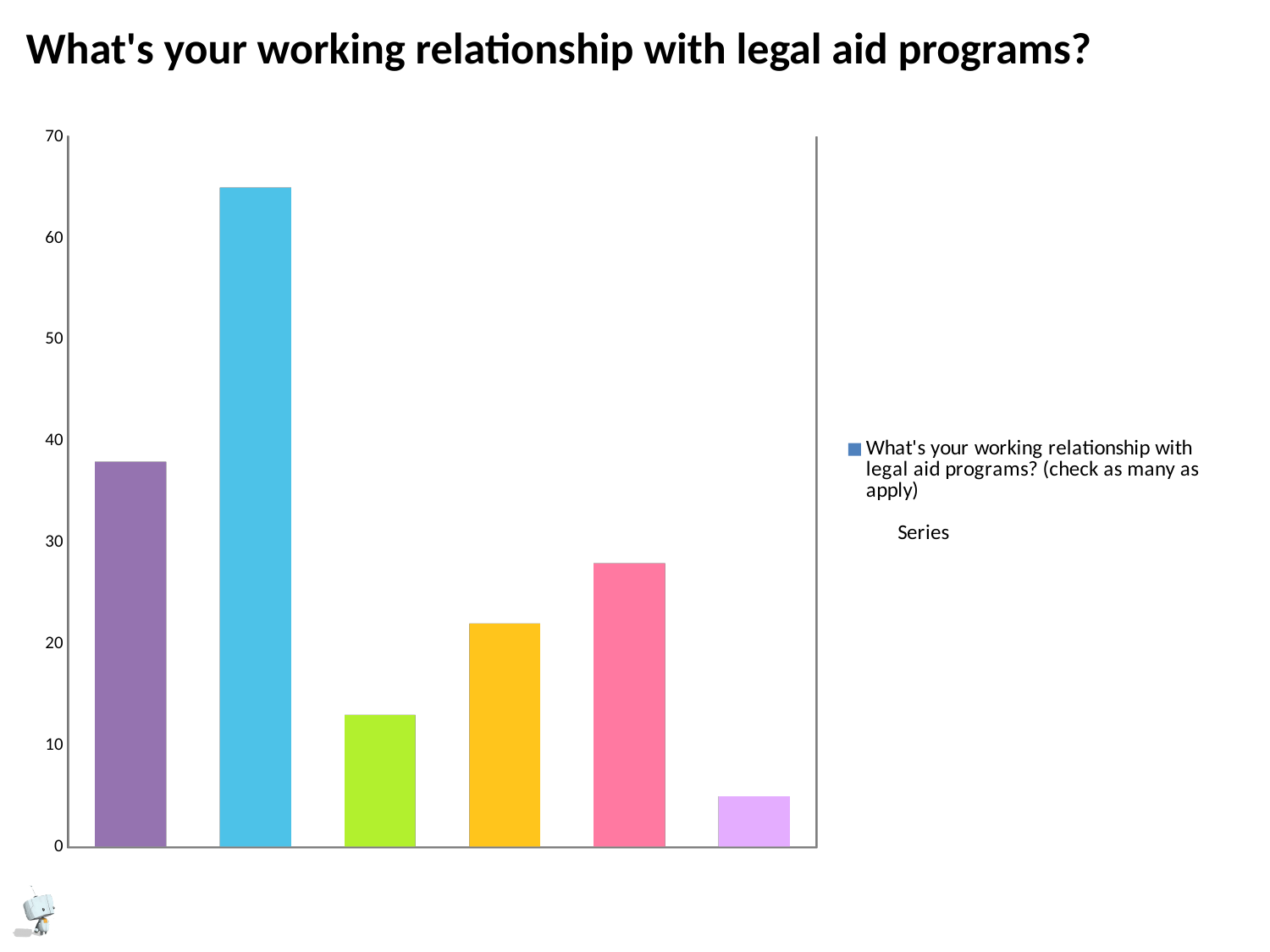
Is the value of the purple bar (leftmost) greater or less than 40? less Is the value of the green bar (third from left) greater or less than 10? greater Is the value of the lavender bar (rightmost) greater or less than 10? less How many series does the legend list? 1 Which bar is the tallest in the chart? the blue bar (second from left) Which is larger, the value of the purple bar or the value of the green bar? the purple bar What is the title of the slide? What's your working relationship with legal aid programs? Which bar is the shortest in the chart? the lavender bar (rightmost) What kind of chart is shown on the slide? bar chart Which is larger, the value of the yellow bar or the value of the pink bar? the pink bar How many bars are plotted in the chart? 6